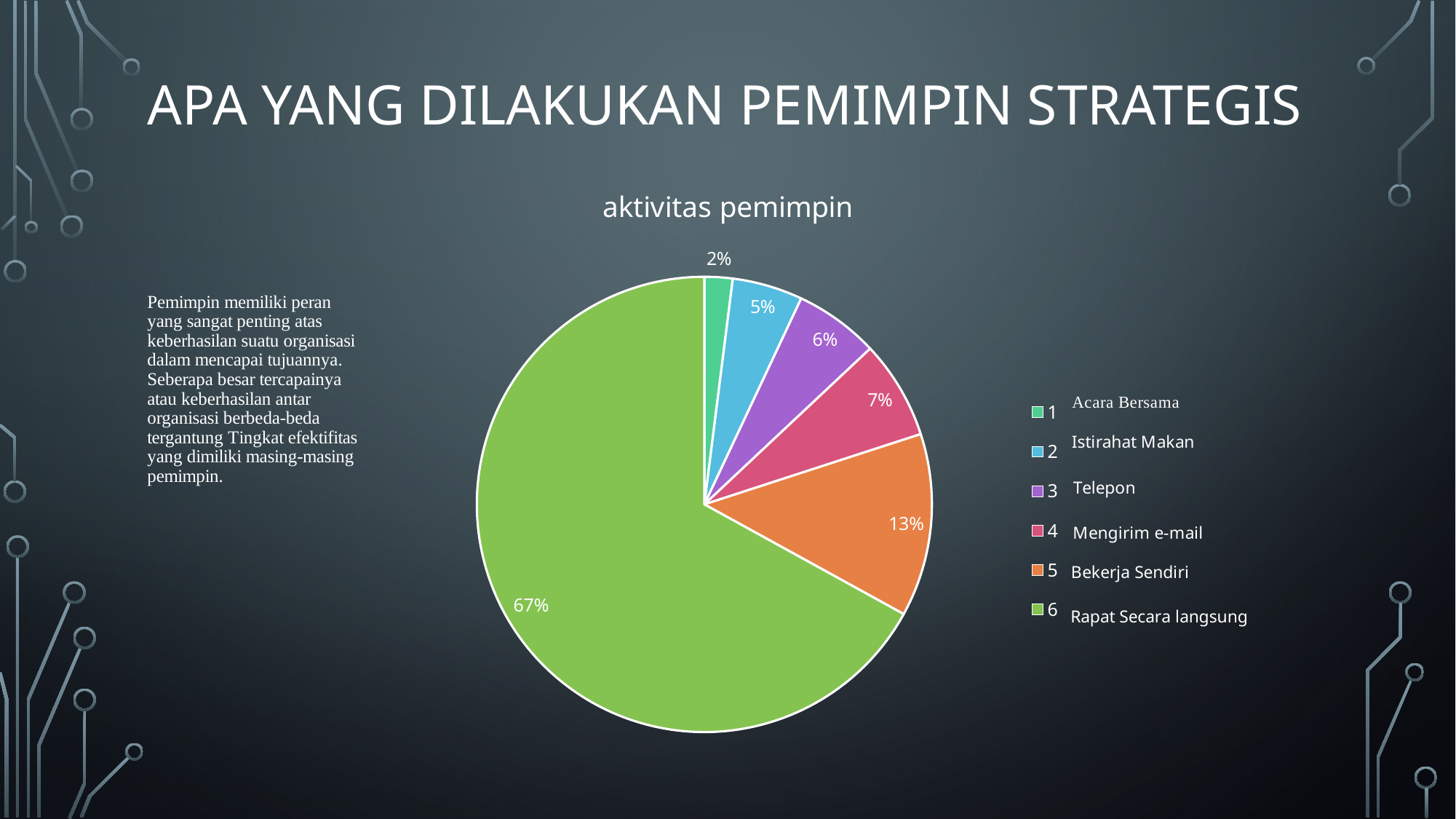
What share of the pie does Bekerja Sendiri take? 13% Which activity has the largest slice of the pie? Rapat Secara langsung How many slices does the pie chart have? 6 What is the difference in percentage points between Rapat Secara langsung and Bekerja Sendiri? 54 What is the title of the chart? aktivitas pemimpin What kind of chart is shown on the slide? pie chart What share of the pie does Rapat Secara langsung take? 67% What share of the pie does Mengirim e-mail take? 7% Which is larger, the slice for Telepon or the slice for Istirahat Makan? Telepon Which activity has the smallest slice of the pie? Acara Bersama